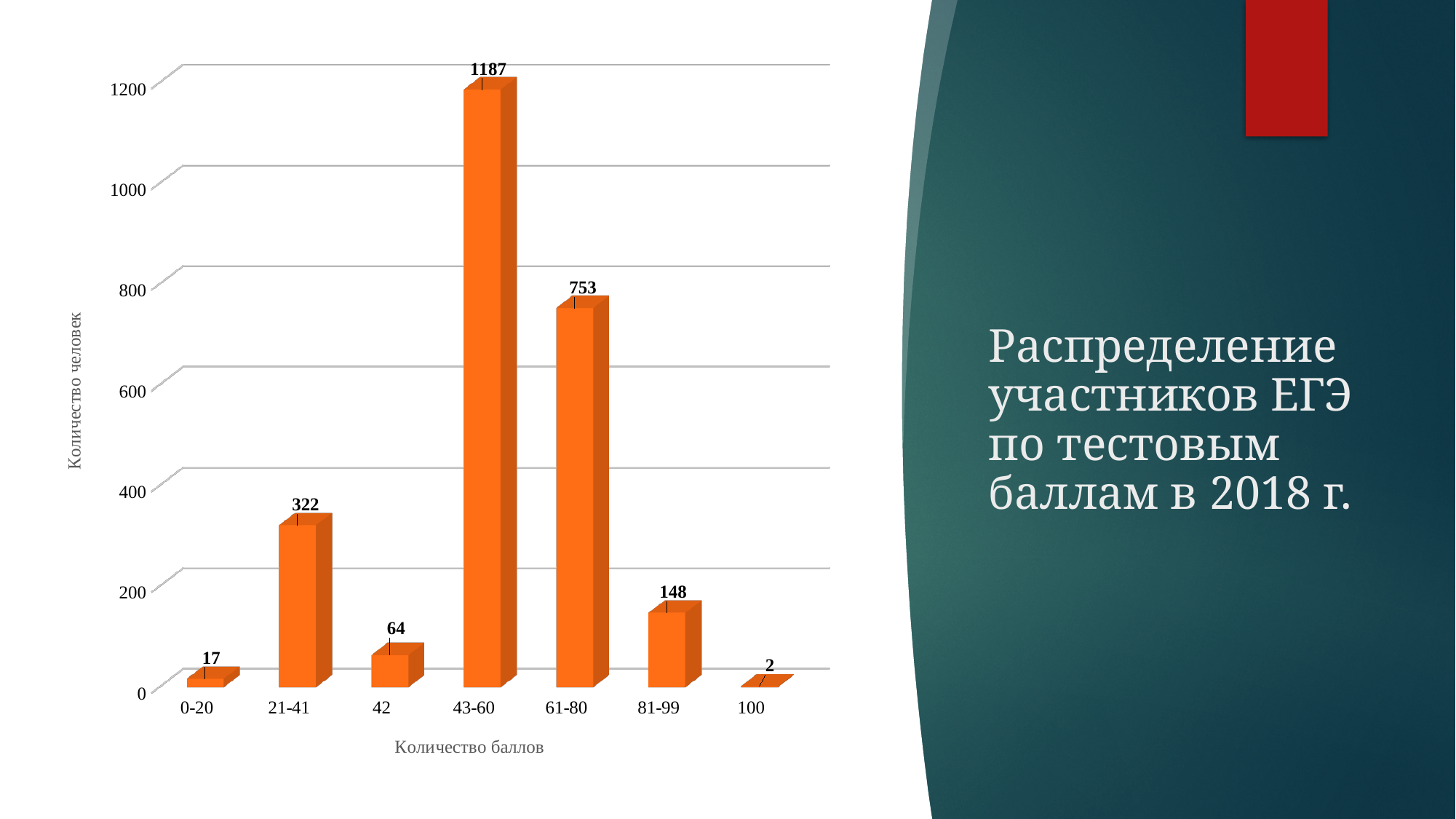
What is the label of the x axis? Количество баллов How many score categories are shown on the x axis? 7 How many participants scored in the 43-60 range? 1187 Which score category has the lowest number of participants? 100 What is the label of the y axis? Количество человек What is the value for the 21-41 score range? 322 What is the difference between the values for 43-60 and 61-80? 434 Is the value for 61-80 greater or less than 800? less Which score range has the highest number of participants? 43-60 What kind of chart is shown on the slide? bar chart Which has more participants: 21-41 or 81-99? 21-41 How many participants scored 100? 2